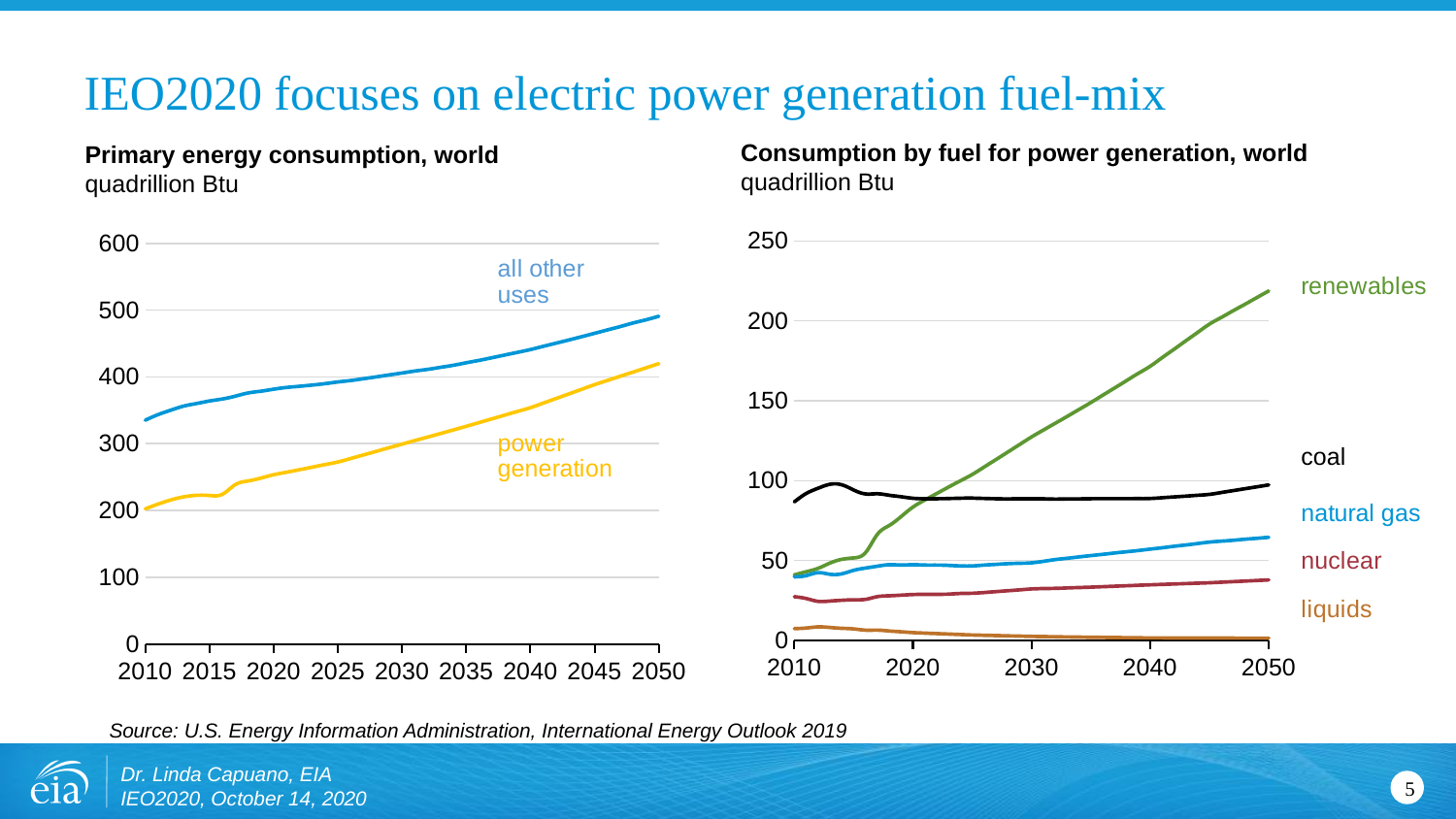
What kind of chart is the 'Primary energy consumption, world' chart on the left? line chart On the 'Consumption by fuel for power generation, world' chart, does the liquids line rise or fall from 2010 to 2050? fall On the 'Primary energy consumption, world' chart, is the value for 'all other uses' in 2050 greater or less than 400? greater How many series are plotted on the 'Primary energy consumption, world' chart on the left? 2 On the 'Consumption by fuel for power generation, world' chart, is the value for renewables in 2050 greater or less than 200? greater On the 'Primary energy consumption, world' chart, is the value for 'power generation' in 2010 greater or less than 300? less On the 'Consumption by fuel for power generation, world' chart, which is larger in 2050, coal or natural gas? coal On the 'Consumption by fuel for power generation, world' chart, which fuel has the lowest value in 2050? liquids On the 'Consumption by fuel for power generation, world' chart, which fuel has the highest value in 2010? coal On the 'Consumption by fuel for power generation, world' chart, which fuel has the highest value in 2050? renewables How many series are plotted on the 'Consumption by fuel for power generation, world' chart on the right? 5